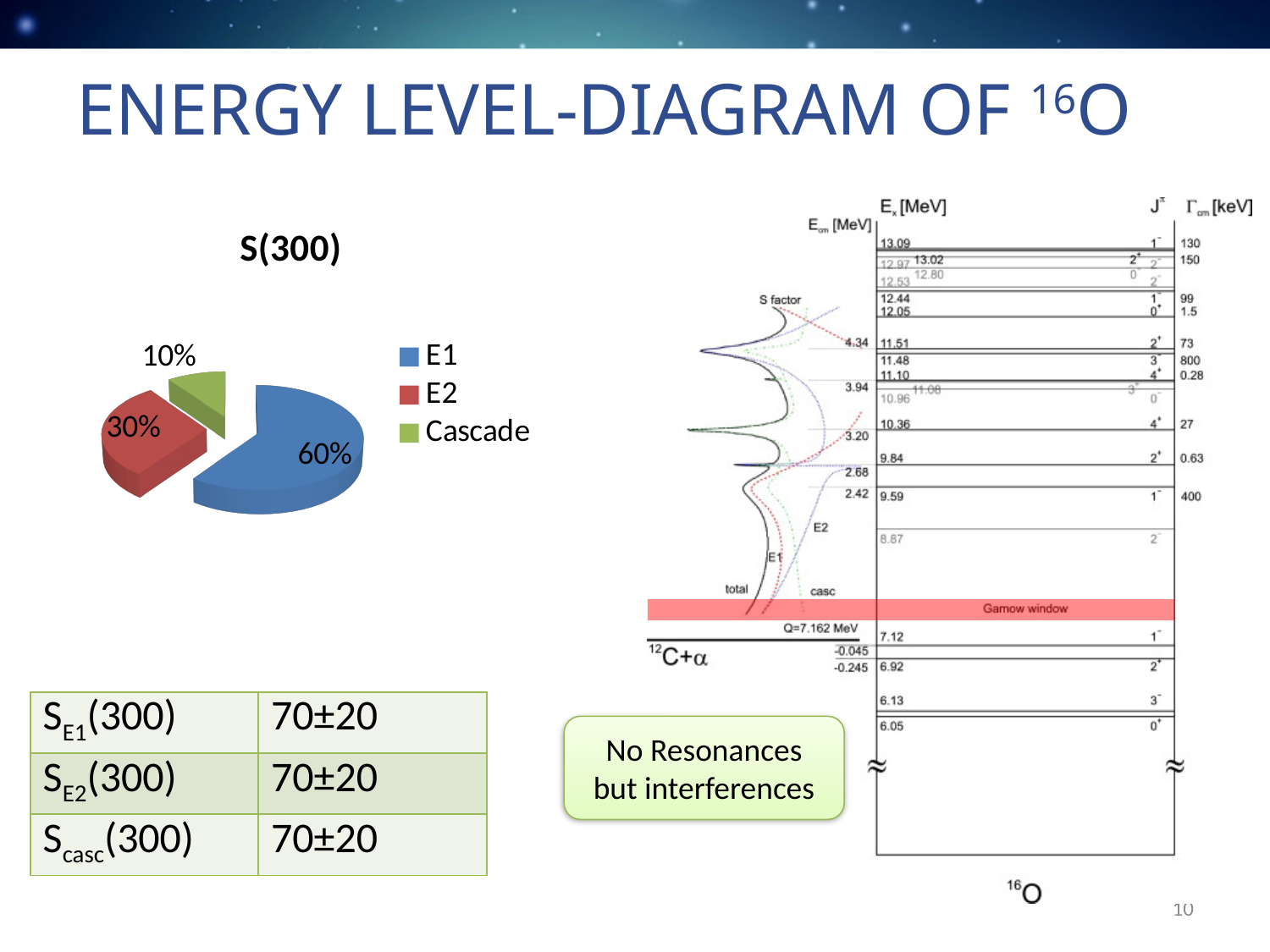
How many slices does the S(300) pie chart have? 3 How many entries does the legend of the S(300) pie chart list? 3 In the S(300) pie chart, which is larger, E2 or Cascade? E2 Which slice of the S(300) pie chart is the largest? E1 What kind of chart is the S(300) chart? pie chart In the S(300) pie chart, how many percentage points larger is E1 than E2? 30 In the S(300) pie chart, what share does E1 have? 60% Which slice of the S(300) pie chart is the smallest? Cascade In the S(300) pie chart, what share does E2 have? 30% What colour is the E1 slice in the S(300) pie chart? blue In the S(300) pie chart, how many percentage points larger is E2 than Cascade? 20 In the S(300) pie chart, what share does Cascade have? 10%